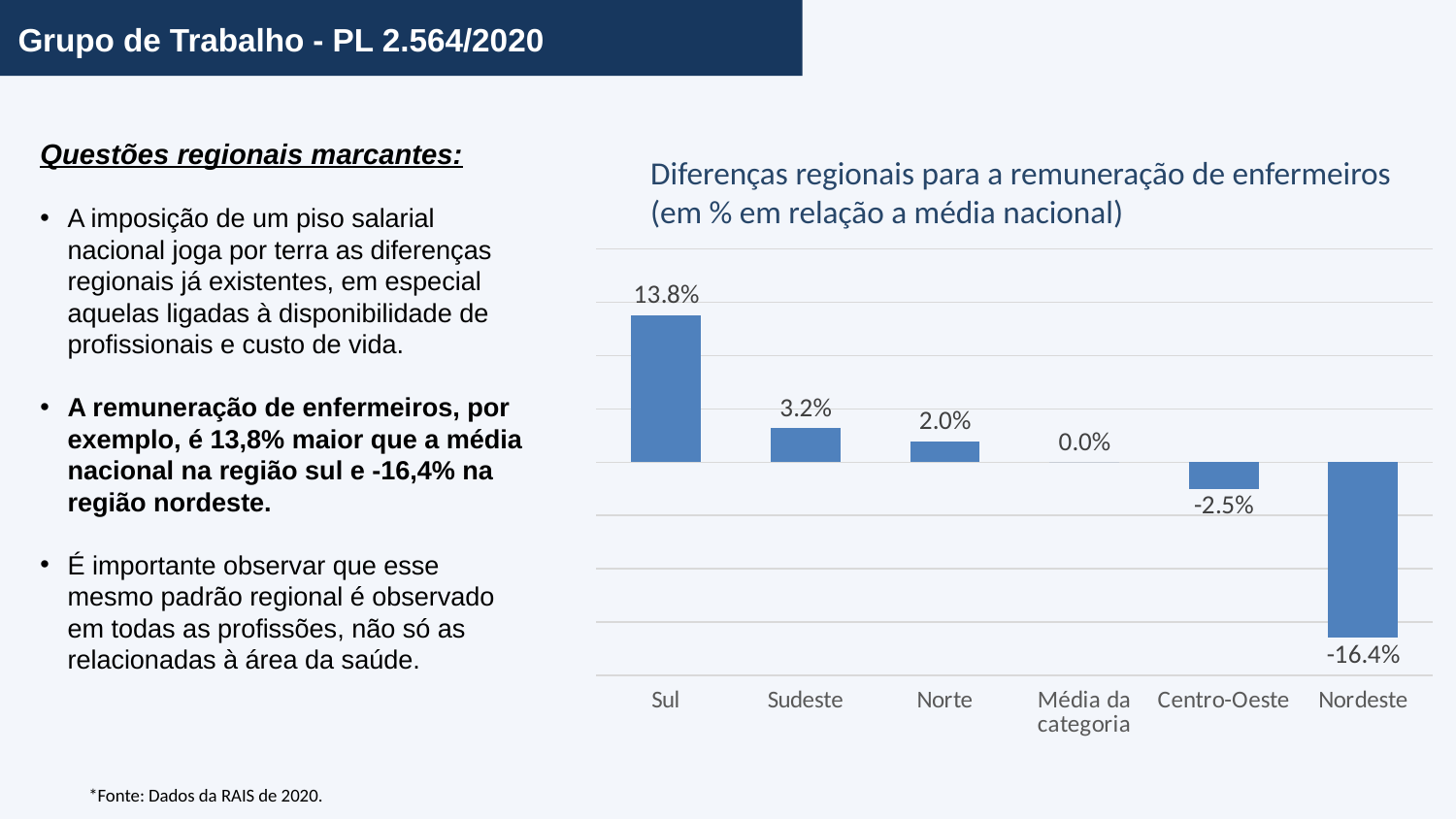
What is the value for Sul? 13.8% Do the values rise or fall from left to right along the x axis? Fall What is the title of the chart? Diferenças regionais para a remuneração de enfermeiros (em % em relação a média nacional) What is the difference between the values for Sul and Sudeste? 10.6% What kind of chart is this? Bar chart Which is larger, the value for Sudeste or the value for Norte? Sudeste Which category has the highest value? Sul What is the value for Norte? 2.0% What is the value for Centro-Oeste? -2.5% Which category has the lowest value? Nordeste What is the value for Nordeste? -16.4% How many categories are shown on the x axis? 6